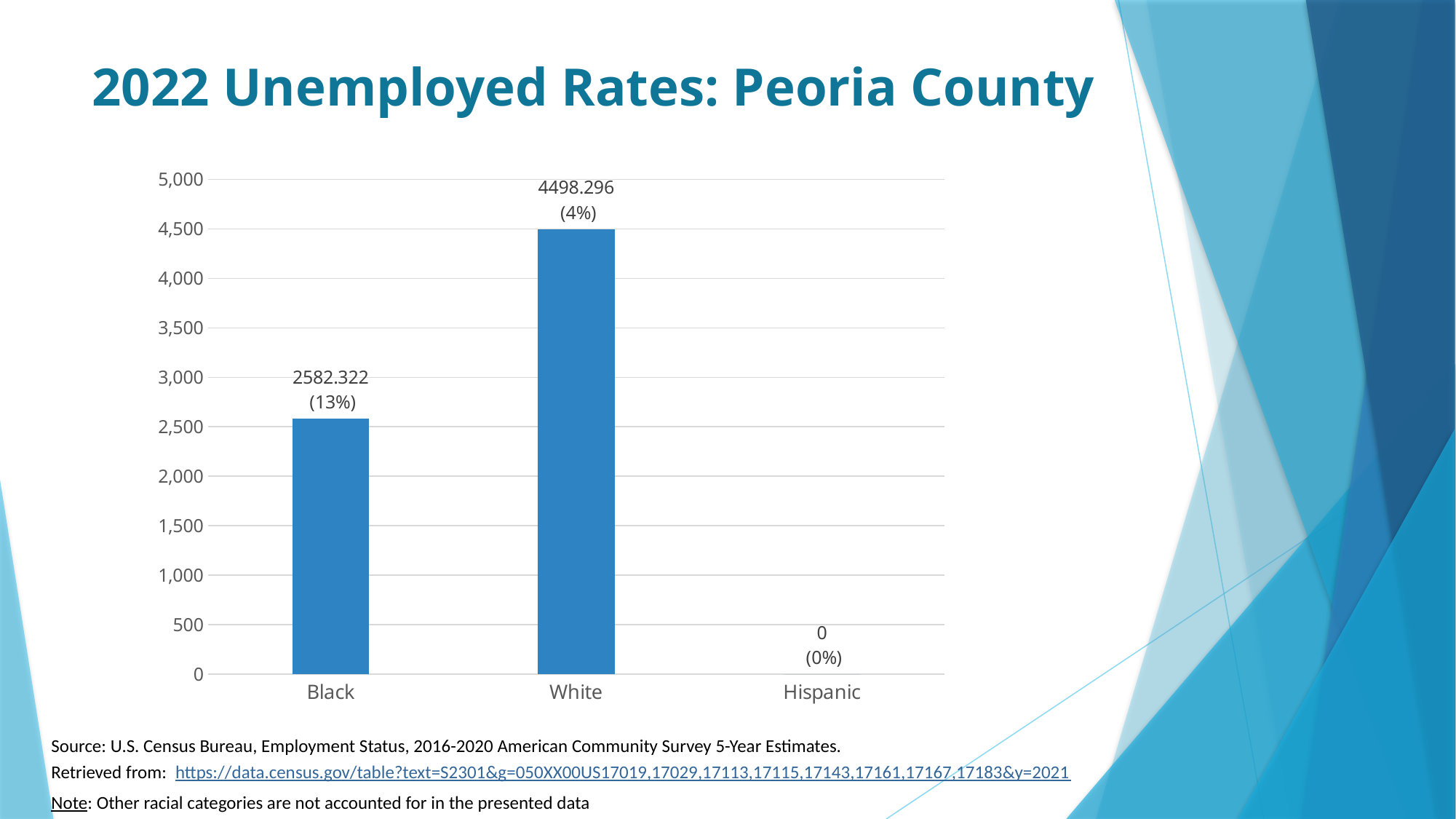
What is the value shown for Hispanic? 0 What is the title of the slide? 2022 Unemployed Rates: Peoria County What is the value shown for White? 4498.296 What percentage is shown in parentheses for Black? 13% What is the value shown for Black? 2582.322 Which is larger, the value for Black or the value for White? White Which category has the lowest value? Hispanic What is the difference between the values for White and Black? 1915.974 How many categories are shown on the x axis? 3 Which category has the highest value? White What percentage is shown in parentheses for White? 4% What kind of chart is shown on the slide? Bar chart